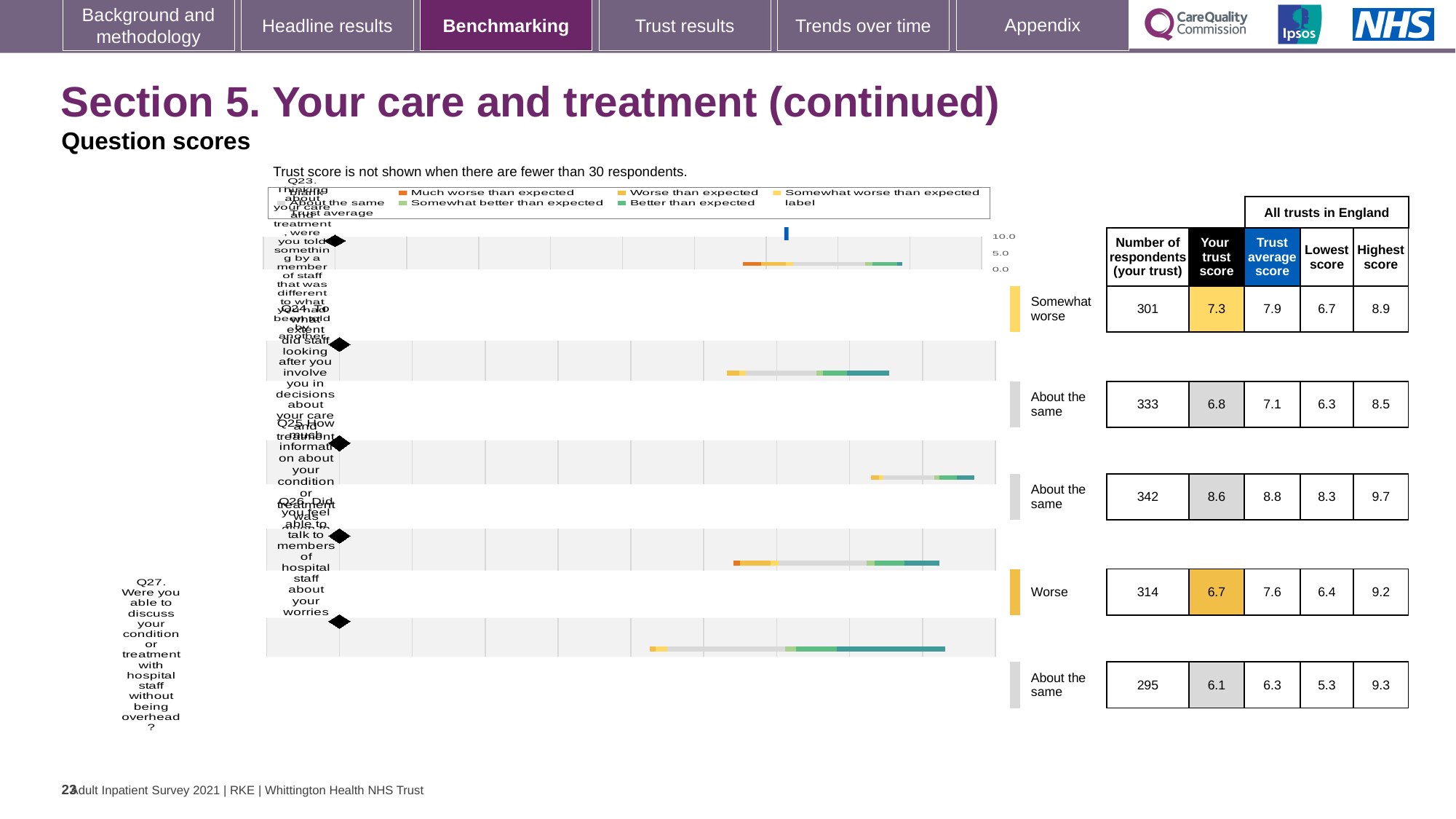
How many respondents answered Q25 at this trust? 342 How many questions (Q23 to Q27) are plotted on this slide? 5 What is the highest score across all trusts in England for Q24? 8.5 What benchmark category is shown for Q26? Worse What is the difference between the trust average score and your trust score for Q26? 0.9 What kind of chart is used to show the question scores? Bar chart Which is larger for Q23: your trust score or the trust average score? Trust average score What is the trust score for Q27 (discussing your condition or treatment without being overheard)? 6.1 Which question has the highest 'Your trust score' on this slide? Q25 What is the trust average score for Q26? 7.6 Which question has the lowest 'Your trust score' on this slide? Q27 What is the lowest score across all trusts in England for Q27? 5.3